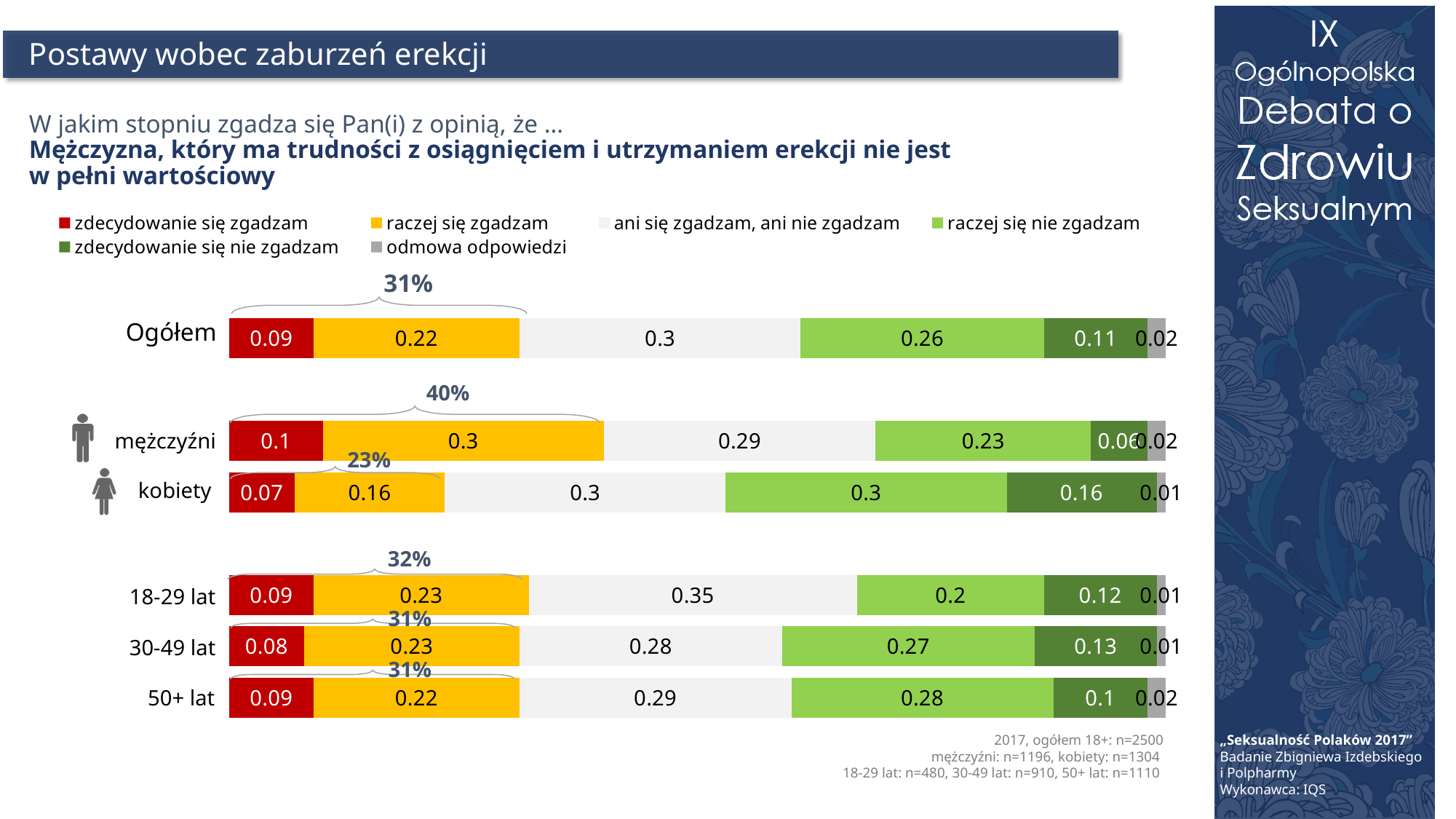
Which has the larger "zdecydowanie się nie zgadzam" value, 30-49 lat or 50+ lat? 30-49 lat What is the value for "zdecydowanie się nie zgadzam" in the kobiety bar? 0.16 What is the difference between the "raczej się nie zgadzam" values for kobiety and mężczyźni? 0.07 What colour represents "zdecydowanie się zgadzam" in the legend? red What kind of chart is shown on the slide? stacked bar chart How many series does the legend list? 6 What is the value for "ani się zgadzam, ani nie zgadzam" in the 18-29 lat bar? 0.35 What is the value for "raczej się zgadzam" in the mężczyźni bar? 0.3 How many category bars are shown in the chart? 6 What combined percentage is shown above the mężczyźni bar? 40% Which category has the lowest value for "zdecydowanie się zgadzam"? kobiety Which category has the highest value for "raczej się zgadzam"? mężczyźni